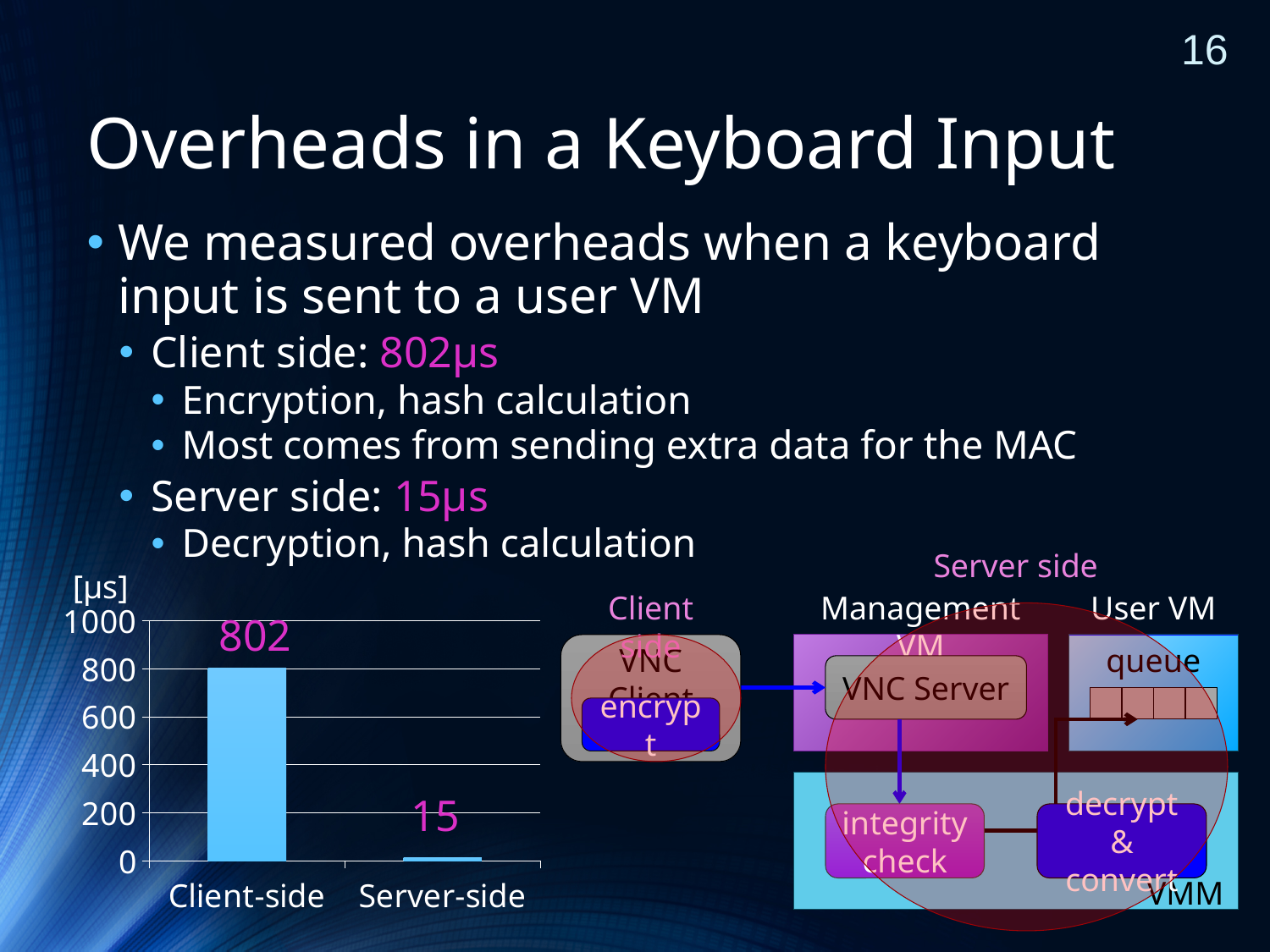
What is the difference between the Client-side and Server-side values in the bar chart? 787 What is the value for Server-side in the bar chart? 15 What unit is shown on the y axis of the bar chart? [μs] Which is larger in the bar chart, Client-side or Server-side? Client-side What is the value for Client-side in the bar chart? 802 Is the value for Server-side greater or less than 200? less What is the maximum value shown on the y axis of the bar chart? 1000 Is the value for Client-side greater or less than 600? greater Which category has the highest value in the bar chart? Client-side Which category has the lowest value in the bar chart? Server-side What kind of chart is shown on the slide? bar chart How many categories are shown in the bar chart? 2